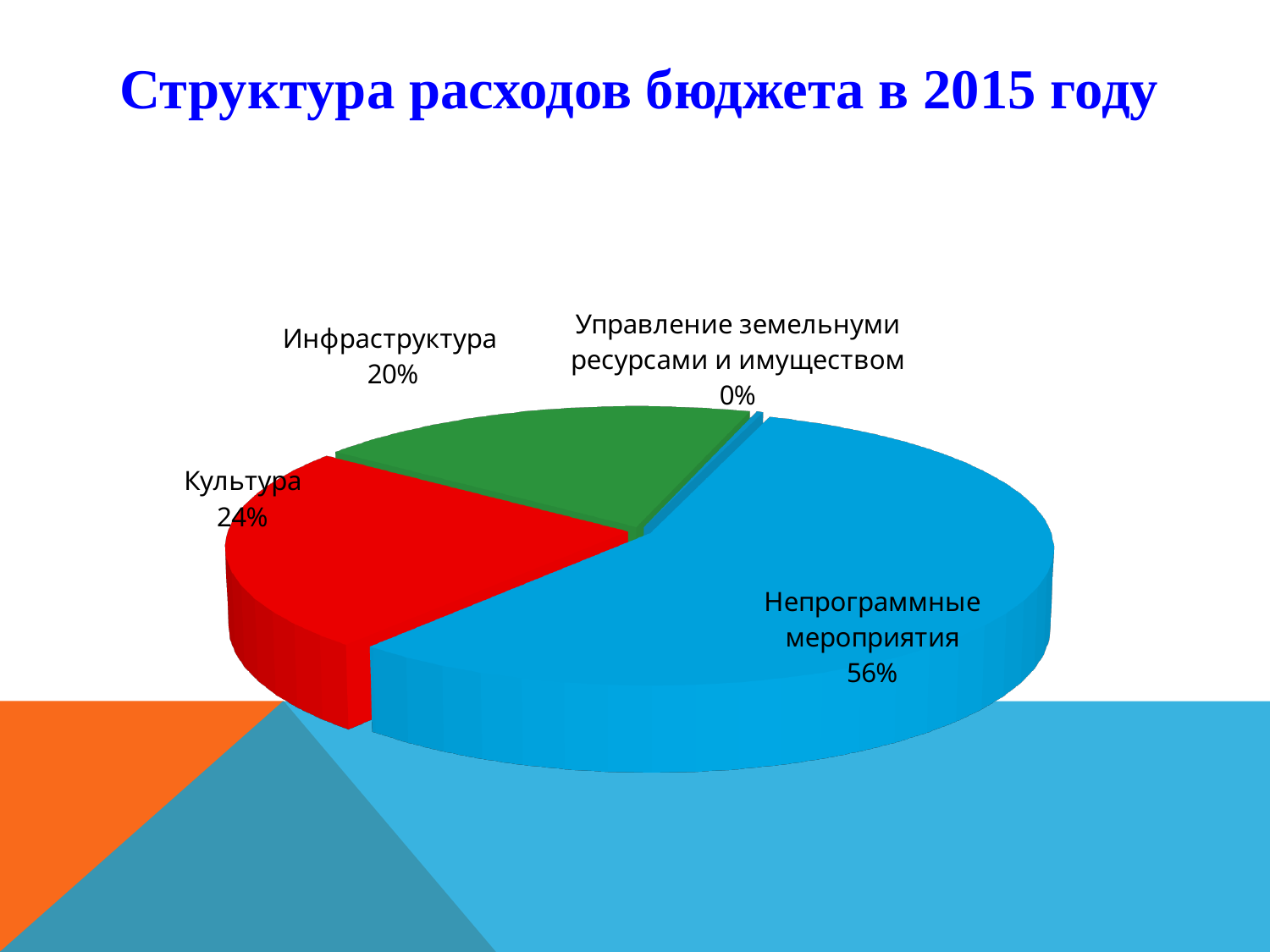
Which category has the smallest share of the pie? Управление земельнуми ресурсами и имуществом What is the title of the chart on the slide? Структура расходов бюджета в 2015 году What share of the pie does Управление земельнуми ресурсами и имуществом have? 0% What colour is the slice for Культура? red What is the difference in percentage points between Непрограммные мероприятия and Культура? 32 What kind of chart is shown on the slide? pie chart What share of the pie does Непрограммные мероприятия have? 56% How many categories are shown in the pie chart? 4 Which is larger, the share for Культура or the share for Инфраструктура? Культура Which category has the largest share of the pie? Непрограммные мероприятия What share of the pie does Инфраструктура have? 20%